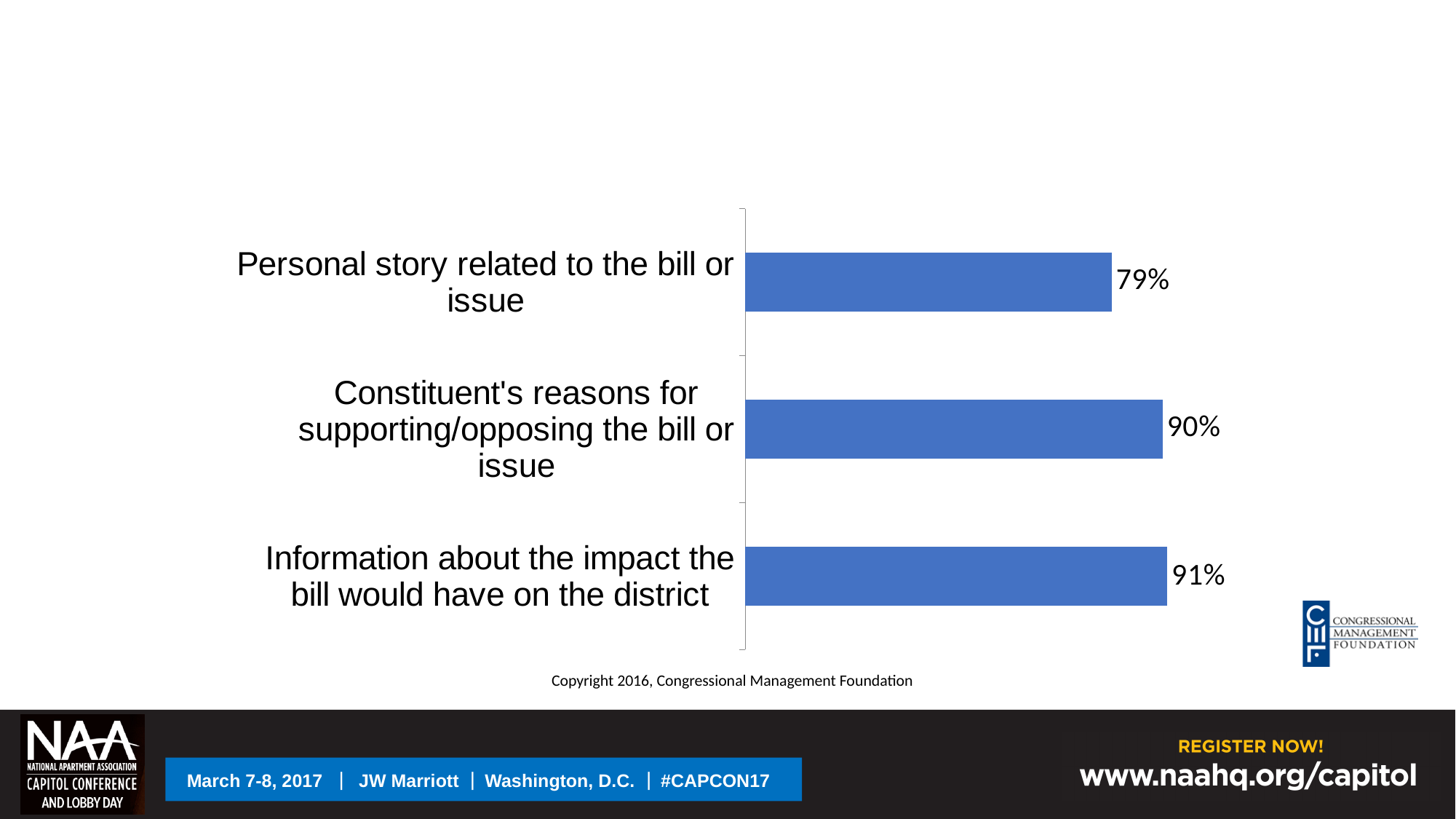
How many categories are shown in the chart? 3 What is the difference between the values for "Information about the impact the bill would have on the district" and "Personal story related to the bill or issue"? 12% Which is larger: the value for "Constituent's reasons for supporting/opposing the bill or issue" or the value for "Personal story related to the bill or issue"? Constituent's reasons for supporting/opposing the bill or issue What is the value for "Constituent's reasons for supporting/opposing the bill or issue"? 90% What colour are the bars in the chart? Blue Which category has the highest value? Information about the impact the bill would have on the district What is the difference between the values for "Constituent's reasons for supporting/opposing the bill or issue" and "Personal story related to the bill or issue"? 11% Which category has the lowest value? Personal story related to the bill or issue What is the value for "Personal story related to the bill or issue"? 79% What is the value for "Information about the impact the bill would have on the district"? 91% What copyright notice appears below the chart? Copyright 2016, Congressional Management Foundation What kind of chart is shown on the slide? Bar chart